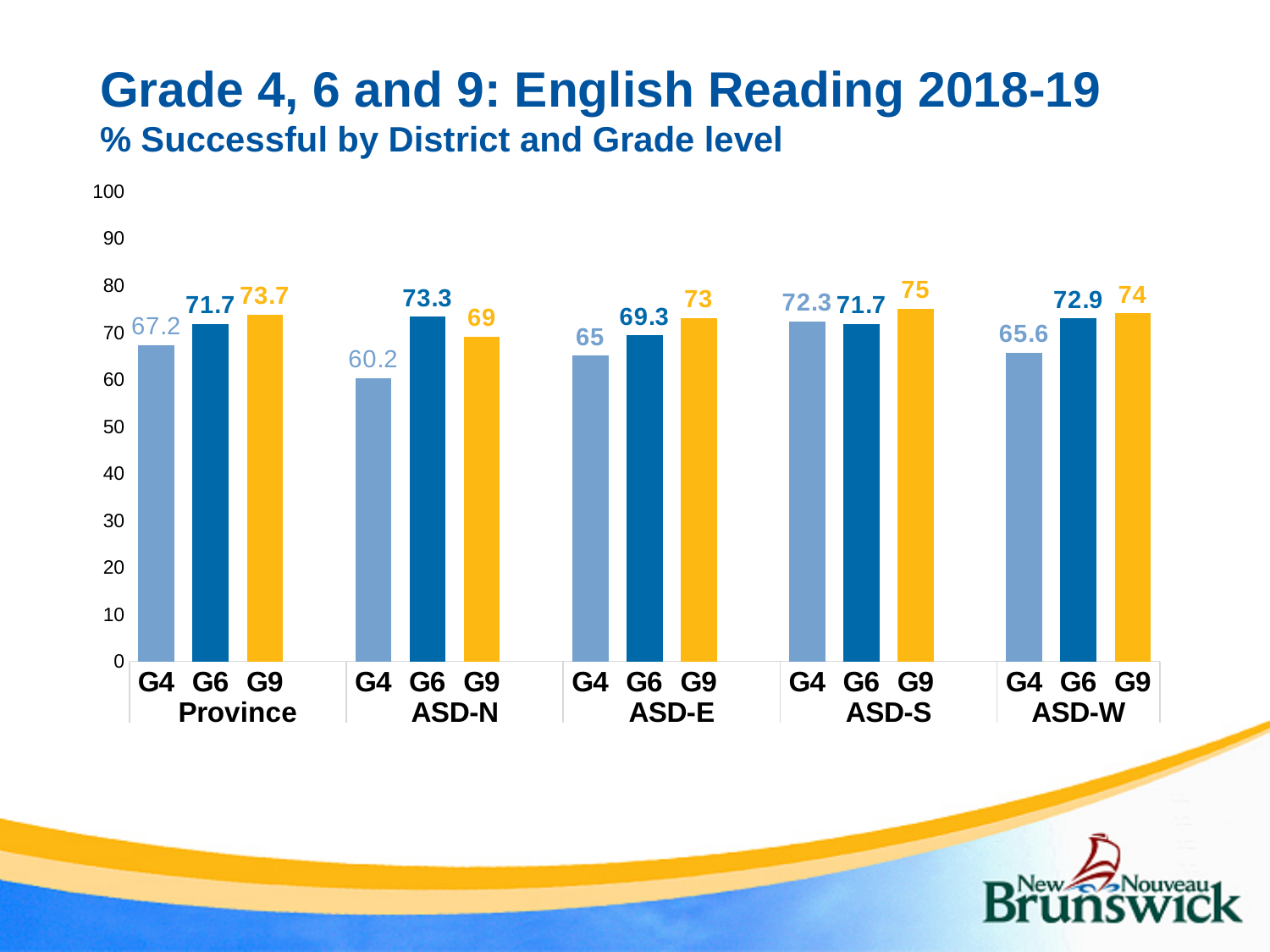
What is the G4 value for ASD-N? 60.2 What is the G4 value for ASD-W? 65.6 Which district has the highest G9 value? ASD-S What is the difference between the G9 value for ASD-S and the G9 value for ASD-E? 2 How many districts (category groups) are shown on the x axis? 5 What is the G6 value for the Province? 71.7 Which is larger, the G6 value for ASD-N or the G6 value for ASD-E? G6 for ASD-N What is the subtitle of the chart? % Successful by District and Grade level What is the G9 value for ASD-S? 75 What kind of chart is shown on the slide? Bar chart What is the difference between the G9 and G4 values for ASD-N? 8.8 Which district has the lowest G4 value? ASD-N